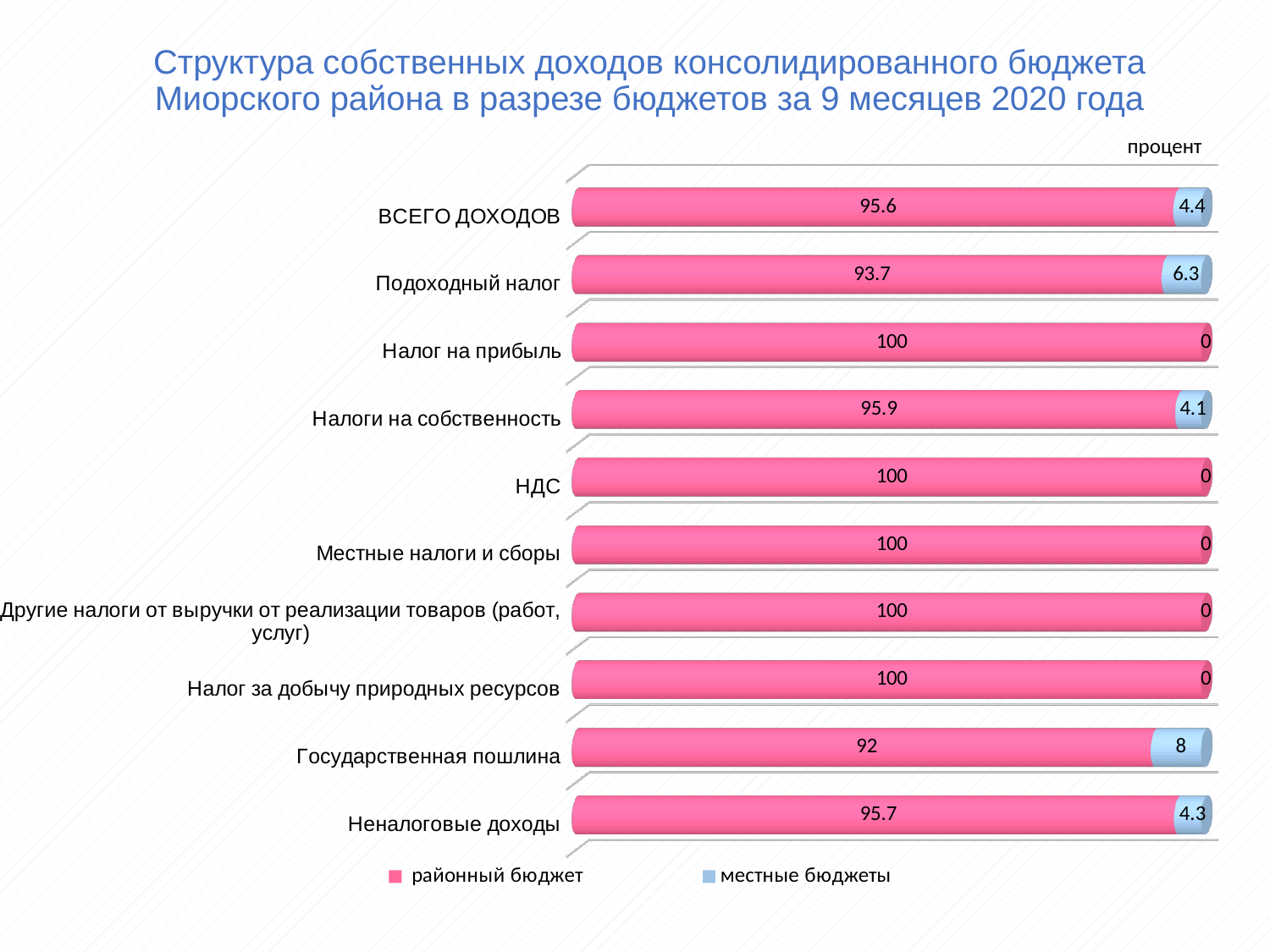
How many categories are shown on the chart? 10 What is the value for районный бюджет for Подоходный налог? 93.7 What is the difference between the районный бюджет values for ВСЕГО ДОХОДОВ and Подоходный налог? 1.9 What is the value for местные бюджеты for ВСЕГО ДОХОДОВ? 4.4 What is the value for местные бюджеты for Государственная пошлина? 8 Which category has the highest value for местные бюджеты? Государственная пошлина How many series does the legend list? 2 What kind of chart is shown on the slide? Stacked bar chart What is the total of the stacked bar for Государственная пошлина? 100 Which category has the lowest value for районный бюджет? Государственная пошлина Which is larger: the местные бюджеты value for Налоги на собственность or for Неналоговые доходы? Неналоговые доходы What is the value for районный бюджет for Неналоговые доходы? 95.7